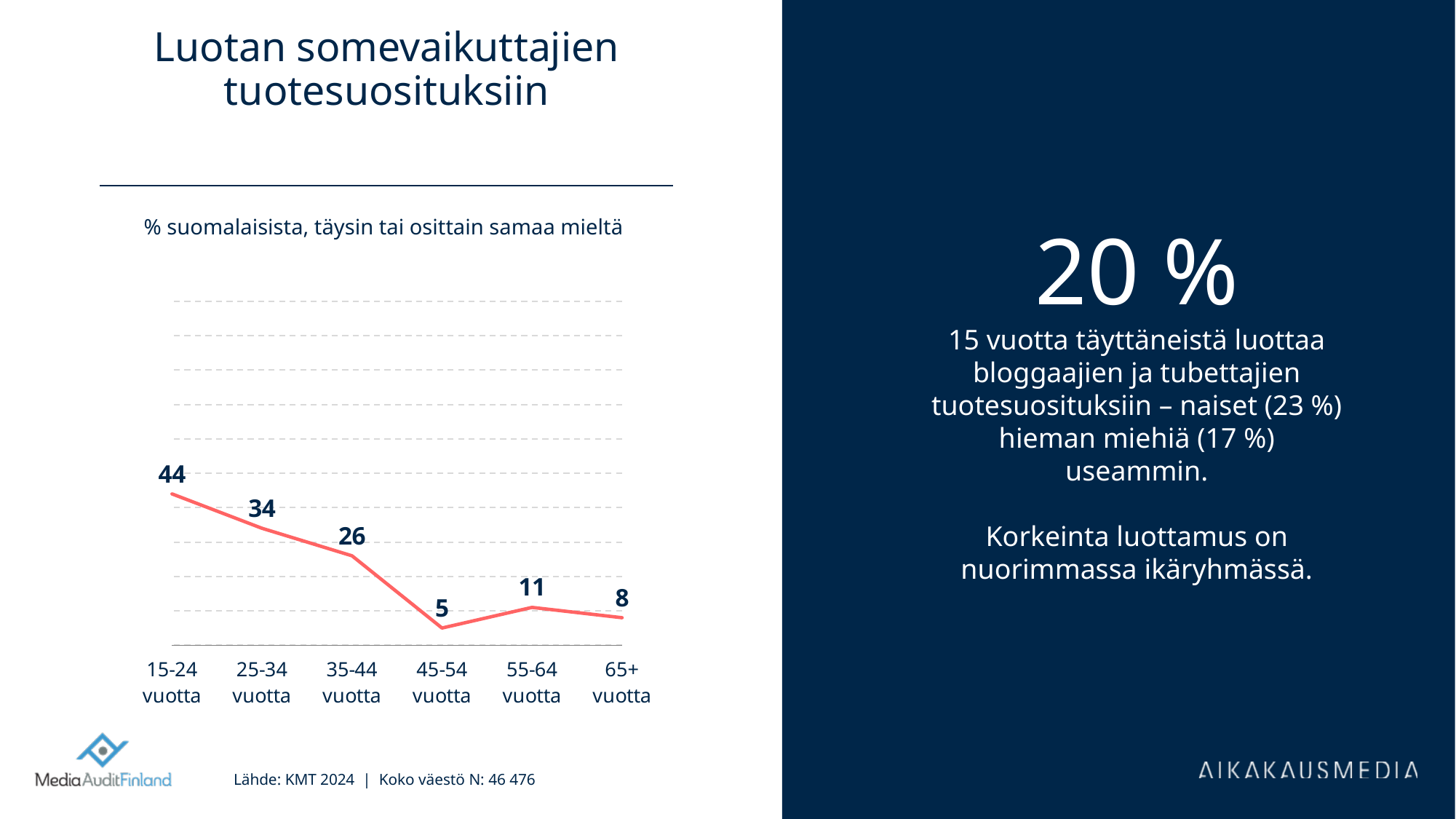
Which is larger, the value for 55-64 vuotta or the value for 65+ vuotta? 55-64 vuotta How many age groups are plotted on the chart? 6 What is the difference between the values for 35-44 vuotta and 45-54 vuotta? 21 What is the value for the 65+ vuotta age group? 8 What kind of chart is shown on the slide? Line chart What is the value for the 45-54 vuotta age group? 5 What is the title of the chart? Luotan somevaikuttajien tuotesuosituksiin What is the value for the 15-24 vuotta age group? 44 Which age group has the highest value? 15-24 vuotta What is the difference between the values for 15-24 vuotta and 25-34 vuotta? 10 Do the values generally rise or fall from the youngest to the oldest age group? Fall Which age group has the lowest value? 45-54 vuotta